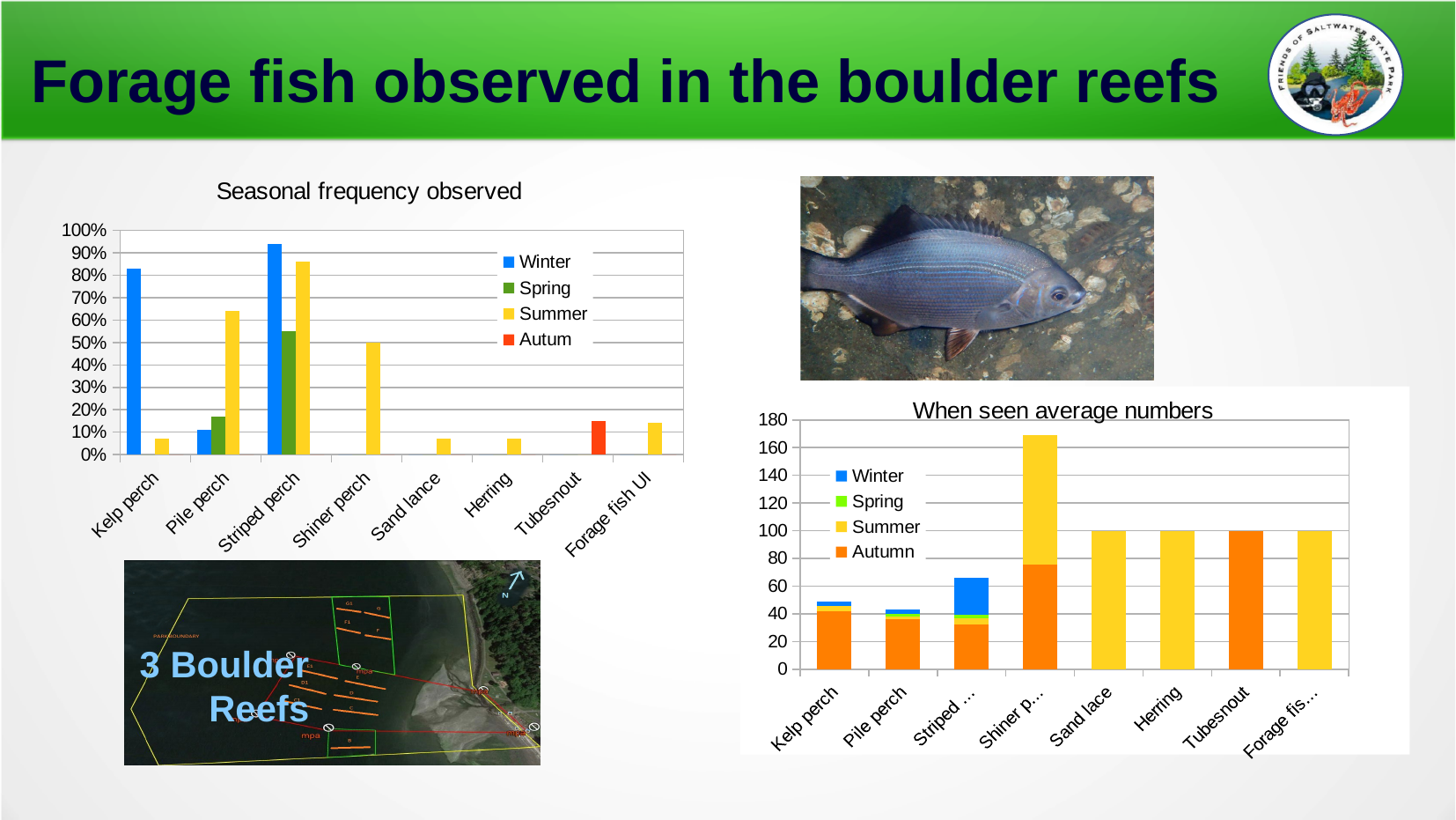
How many fish categories are shown on the x axis of the "Seasonal frequency observed" chart? 8 In the "Seasonal frequency observed" chart, which category has the highest Winter value? Striped perch In the "Seasonal frequency observed" chart, is the Summer value for Pile perch greater or less than 60%? greater In the "When seen average numbers" chart, which category has the tallest stacked bar? Shiner perch In the "When seen average numbers" chart, what is the Summer value for Herring? 100 What kind of chart is the "When seen average numbers" chart? stacked bar chart What kind of chart is the "Seasonal frequency observed" chart? bar chart How many series does the legend of the "Seasonal frequency observed" chart list? 4 In the "Seasonal frequency observed" chart, is the Winter value for Kelp perch greater or less than 80%? greater In the "Seasonal frequency observed" chart, which category is the only one with an Autum bar? Tubesnout In the "Seasonal frequency observed" chart, which is larger for Striped perch: the Spring value or the Summer value? Summer In the "When seen average numbers" chart, is the total for Shiner perch greater or less than 160? greater